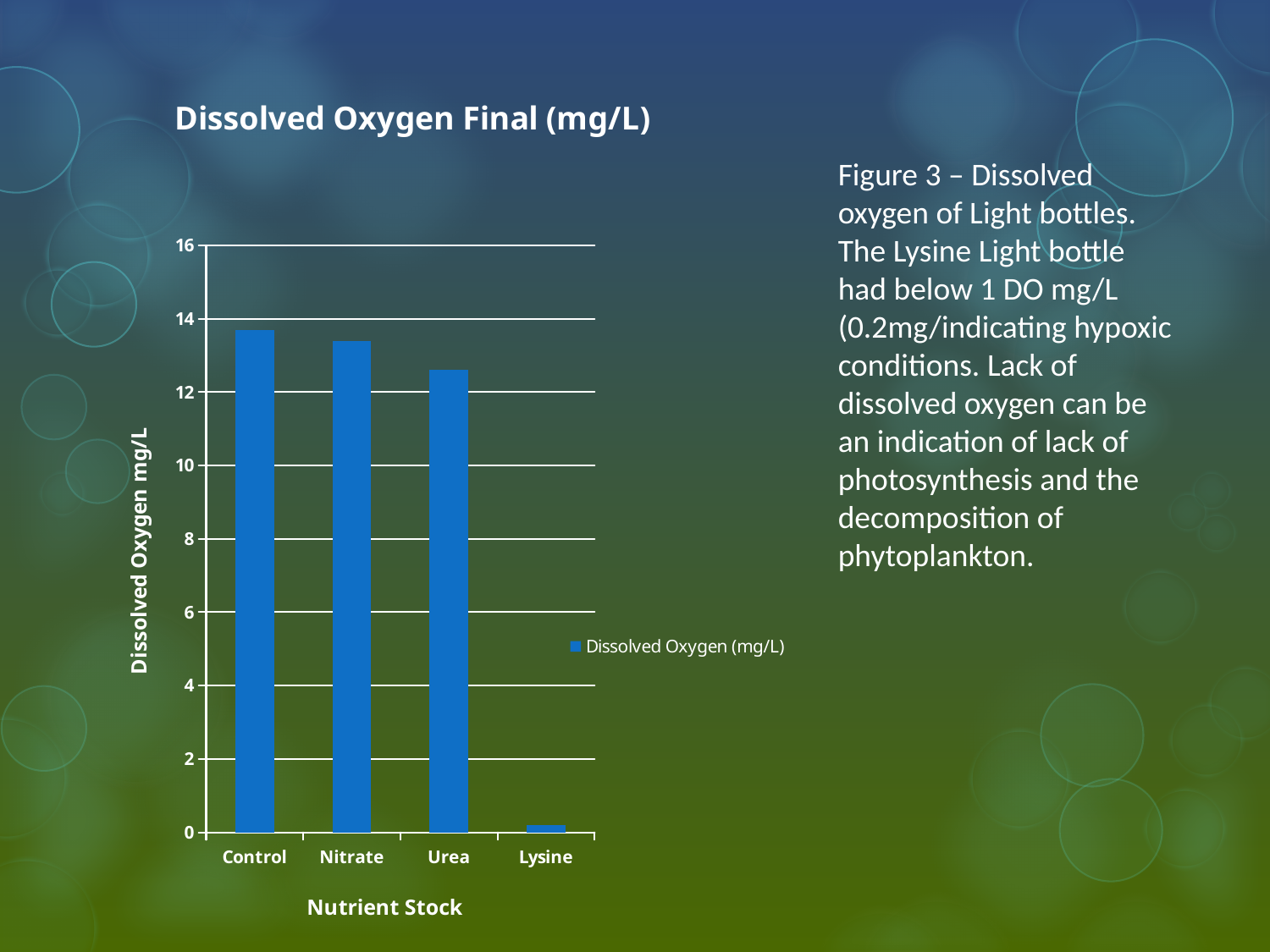
How many series does the chart legend list? 1 Is the dissolved oxygen value for Lysine greater or less than 2? less What is the label on the x axis of the chart? Nutrient Stock Is the dissolved oxygen value for Urea greater or less than 10? greater What kind of chart is shown on the slide? bar chart Is the dissolved oxygen value for Control greater or less than 12? greater Which has a higher dissolved oxygen value, Nitrate or Lysine? Nitrate What is the title of the chart? Dissolved Oxygen Final (mg/L) How many nutrient stock categories are plotted on the chart? 4 Which nutrient stock has the lowest dissolved oxygen value? Lysine Do the dissolved oxygen values rise or fall moving from Control to Lysine along the x axis? fall Which has a higher dissolved oxygen value, Control or Urea? Control